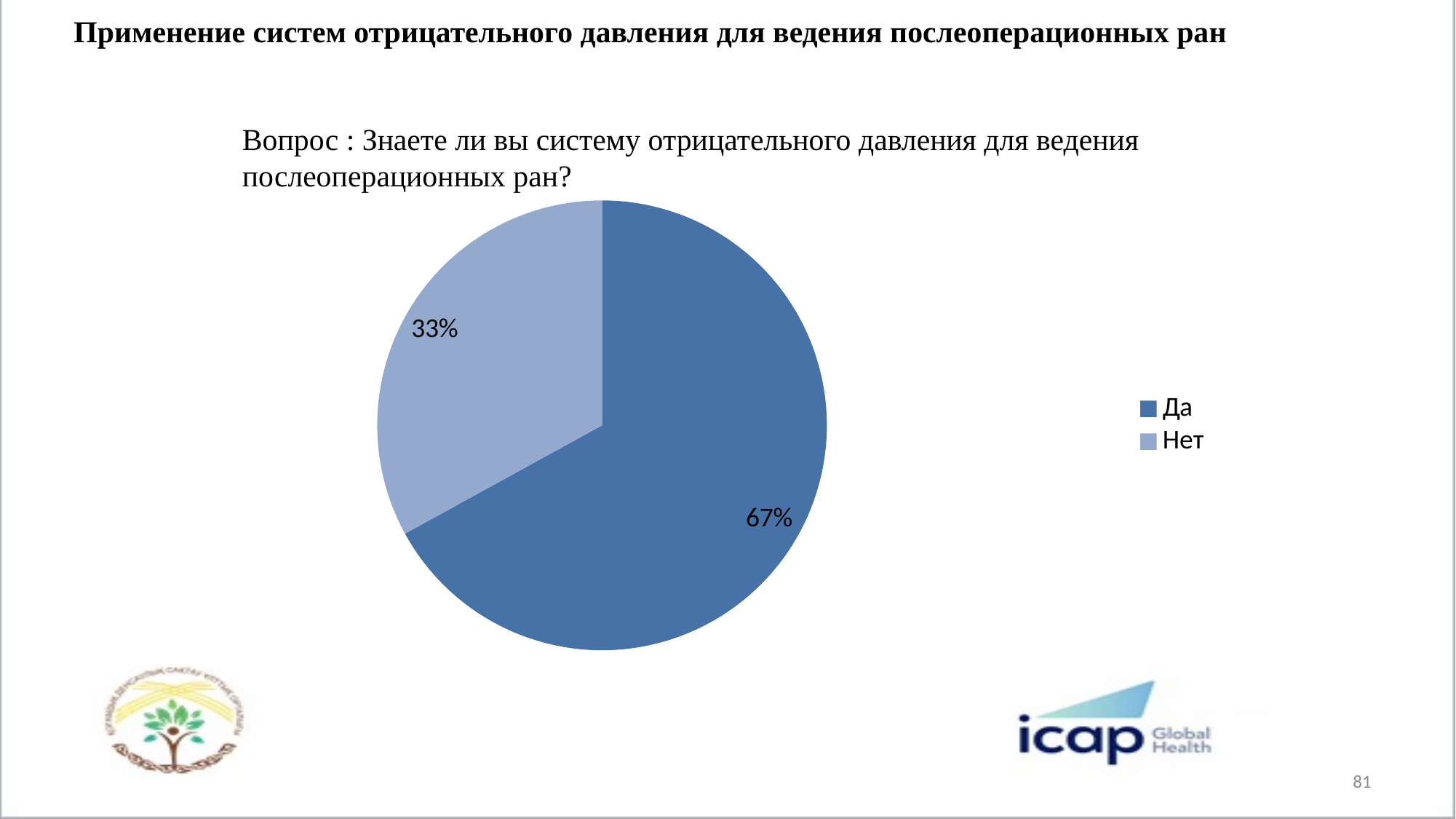
What question is the pie chart answering, as written above it? Знаете ли вы систему отрицательного давления для ведения послеоперационных ран? Which answer has the smallest share of the pie? Нет What share of the pie does the "Нет" slice represent? 33% What percentage of respondents answered "Да"? 67% Which slice is larger, "Да" or "Нет"? Да What is the difference in percentage points between the "Да" and "Нет" slices? 34 What percentage of respondents answered "Нет"? 33% How many slices does the pie chart have? 2 How many entries does the legend list? 2 What kind of chart is shown on the slide? pie chart Which answer has the largest share of the pie? Да Which legend entry is shown in the darker blue colour? Да